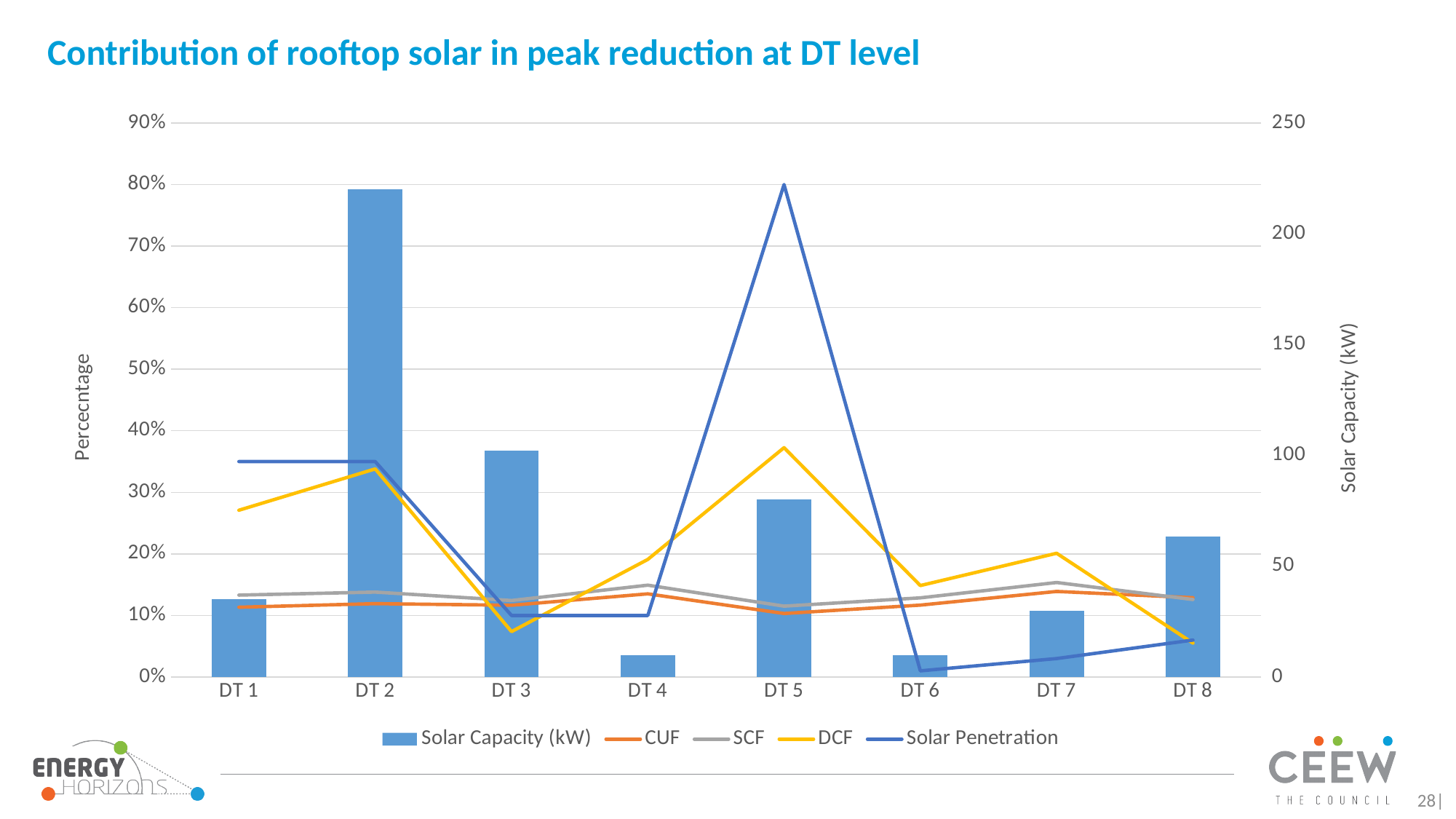
Which DT has the highest Solar Capacity (kW)? DT 2 Which DT has the highest Solar Penetration? DT 5 Is the Solar Capacity (kW) for DT 4 greater or less than 50? less Is the Solar Capacity (kW) for DT 2 greater or less than 200? greater Does Solar Penetration rise or fall from DT 5 to DT 6? fall How many series does the legend list? 5 Which has the larger Solar Capacity (kW), DT 3 or DT 5? DT 3 Which DT has the highest DCF value? DT 5 Is the Solar Penetration for DT 5 greater or less than 70%? greater How many DT categories are shown on the x axis? 8 Which series is plotted as bars rather than lines? Solar Capacity (kW) What kind of chart is shown on the slide? Combined bar and line chart